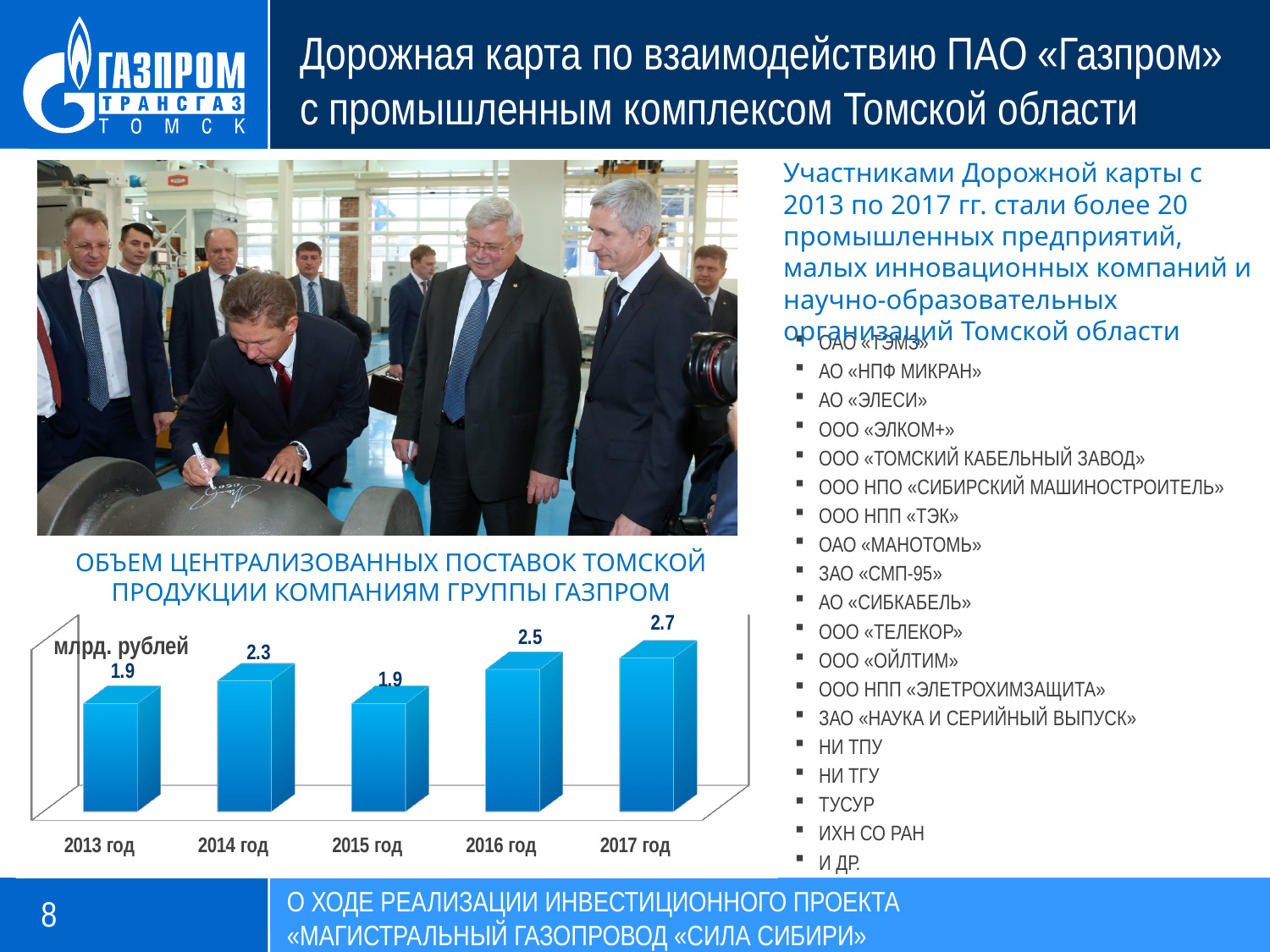
What is the value for 2016 год in the chart? 2.5 Does the value rise or fall from 2015 год to 2017 год? rise What is the value for 2014 год in the chart? 2.3 What type of chart is shown on the slide? bar chart What is the difference between the values for 2017 год and 2013 год? 0.8 What is the value for 2013 год in the chart? 1.9 Which year has the highest value in the chart? 2017 год Which is larger, the value for 2014 год or the value for 2015 год? 2014 год What is the value for 2017 год in the chart? 2.7 In what units are the chart values given? млрд. рублей What is the lowest value shown in the chart? 1.9 How many years (categories) are shown in the chart? 5